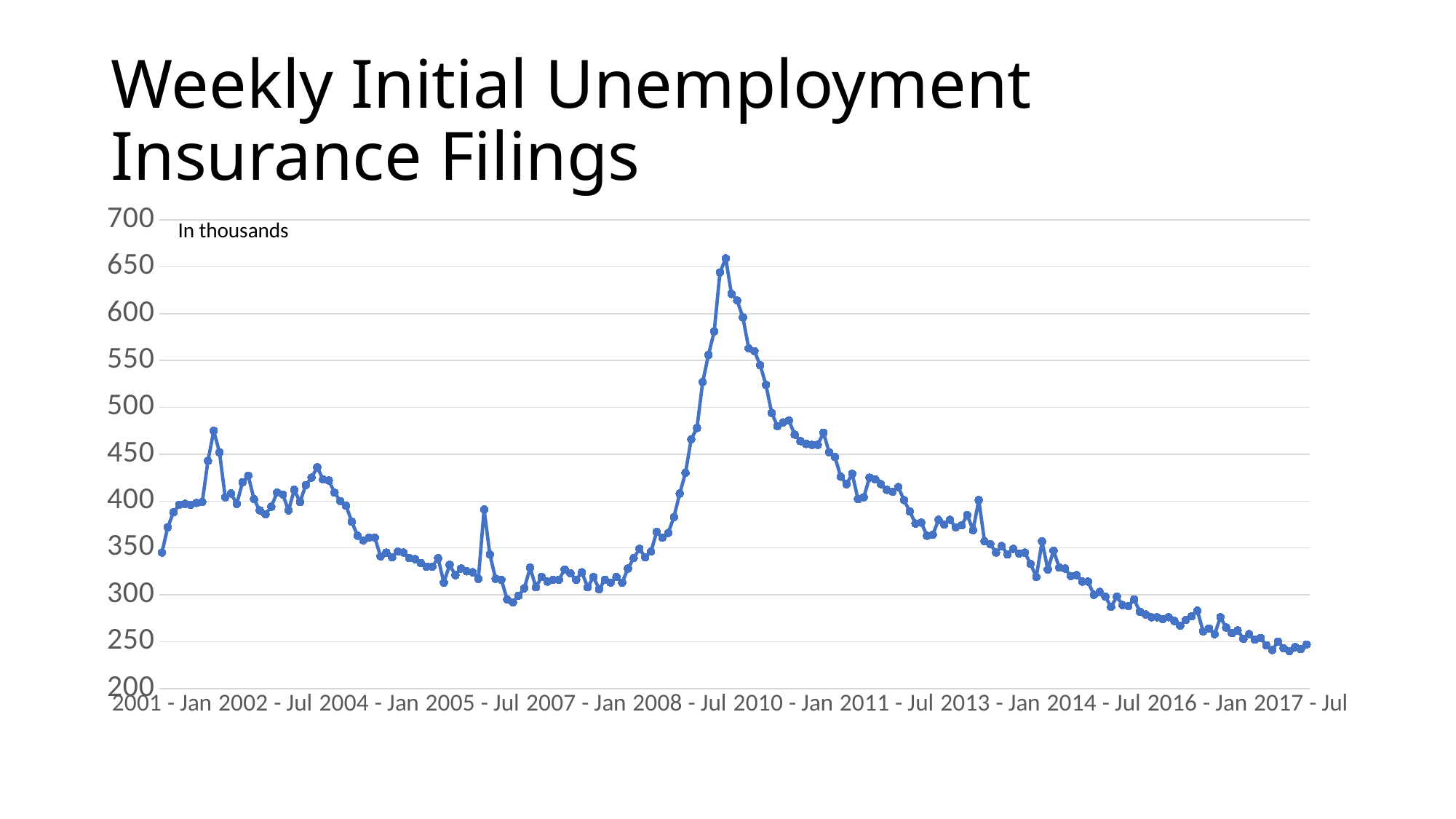
In what units are the values on the chart expressed, according to the note on the chart? In thousands Is the value at 2001 - Jan greater or less than 400? less What is the highest value shown on the vertical axis? 700 Is the peak value of the line greater or less than 600? greater Which is larger, the value at 2001 - Jan or the value at 2017 - Jul? 2001 - Jan What is the title of the chart? Weekly Initial Unemployment Insurance Filings Is the value at 2016 - Jan greater or less than 300? less Do the values generally rise or fall from 2010 - Jan to 2017 - Jul? fall What kind of chart is shown on the slide? Line chart